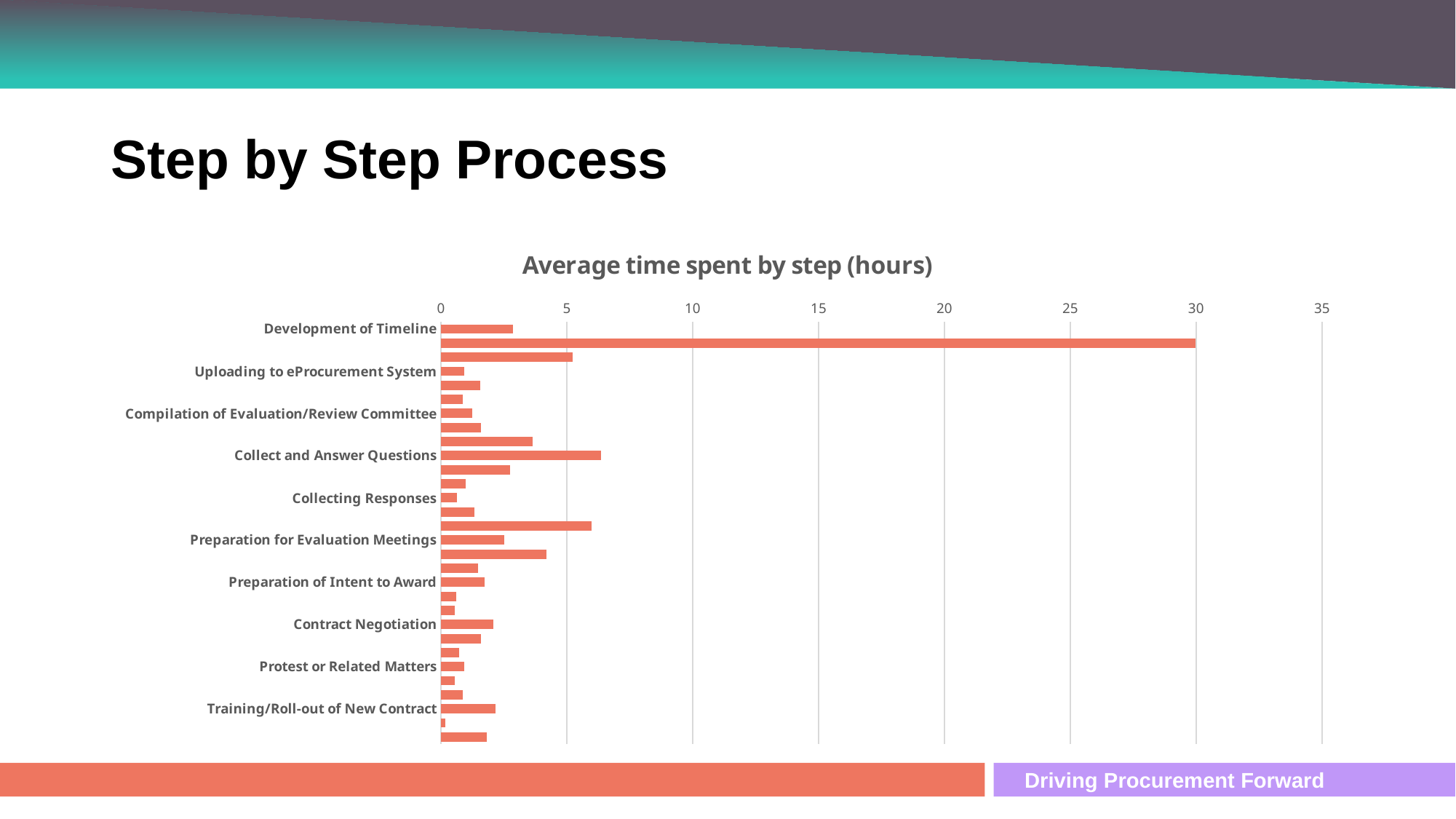
Is the longest bar on the chart greater or less than 25? greater Is the value for Collect and Answer Questions greater or less than 5? greater Which is larger, the value for Collect and Answer Questions or the value for Collecting Responses? Collect and Answer Questions Is the value for Preparation for Evaluation Meetings greater or less than 5? less Which is larger, the value for Collect and Answer Questions or the value for Development of Timeline? Collect and Answer Questions What kind of chart is shown on the slide? bar chart What is the title of the chart? Average time spent by step (hours) How many category labels are shown on the vertical axis of the chart? 10 What is the highest tick value shown on the horizontal axis? 35